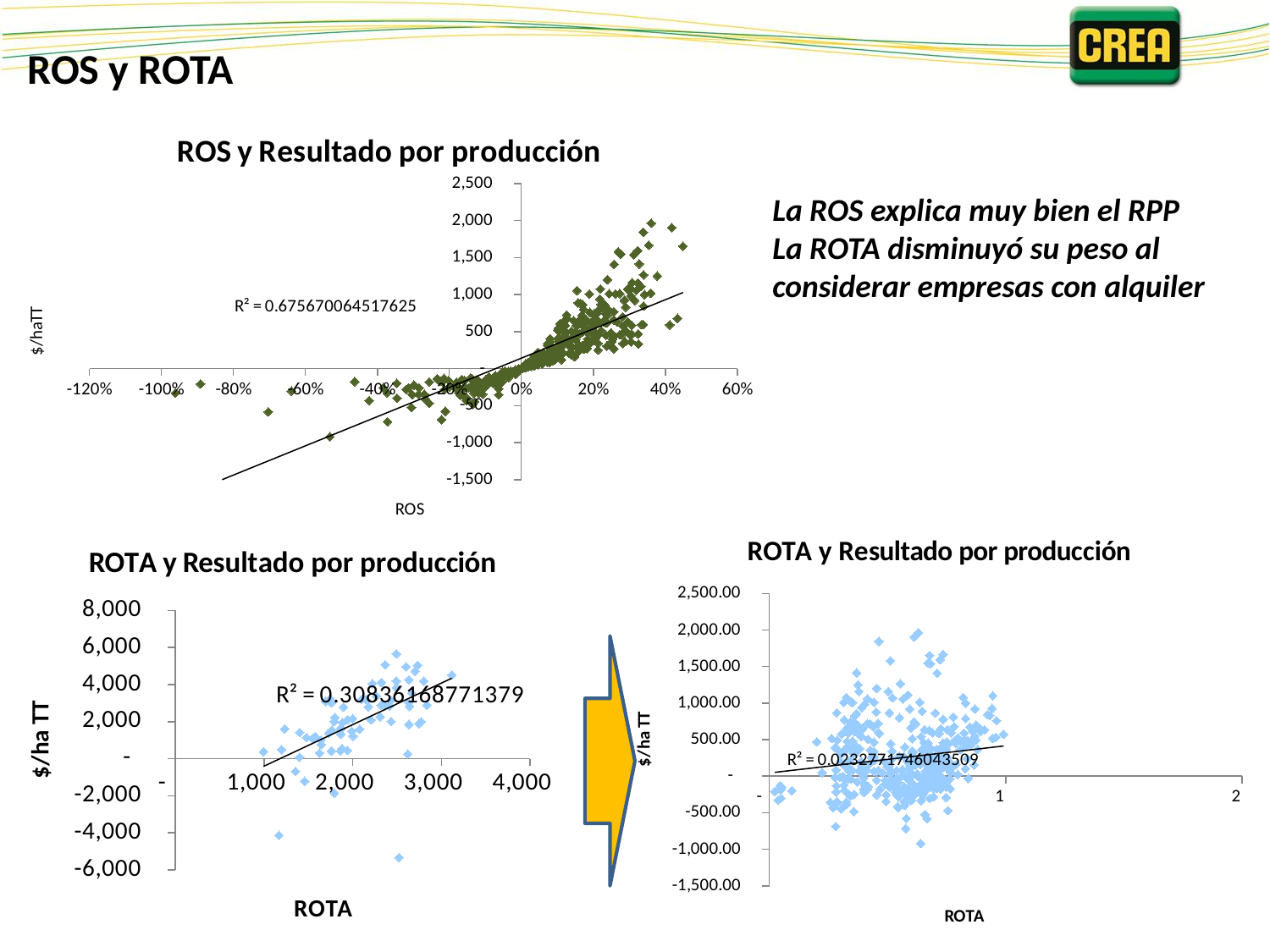
In the top chart 'ROS y Resultado por producción', does the fitted trend line rise or fall as ROS increases along the x axis? rise How many charts are shown on the slide? 3 What is the y-axis label of the bottom-left chart 'ROTA y Resultado por producción'? $/ha TT In the bottom-right chart 'ROTA y Resultado por producción', what R² value is printed on the chart? R² = 0.0232771746043509 Is the R² value in the bottom-left ROTA chart larger or smaller than the R² value in the bottom-right ROTA chart? larger Which chart on the slide shows the lowest R² value? the bottom-right ROTA y Resultado por producción chart What is the x-axis label of the top chart 'ROS y Resultado por producción'? ROS In the top chart 'ROS y Resultado por producción', what R² value is printed on the chart? R² = 0.675670064517625 What type of chart is the top chart titled 'ROS y Resultado por producción'? scatter chart Which chart on the slide shows the highest R² value? ROS y Resultado por producción (top chart) In the bottom-left chart 'ROTA y Resultado por producción', does the fitted trend line rise or fall as ROTA increases? rise In the bottom-left chart 'ROTA y Resultado por producción', what R² value is printed on the chart? R² = 0.30836168771379